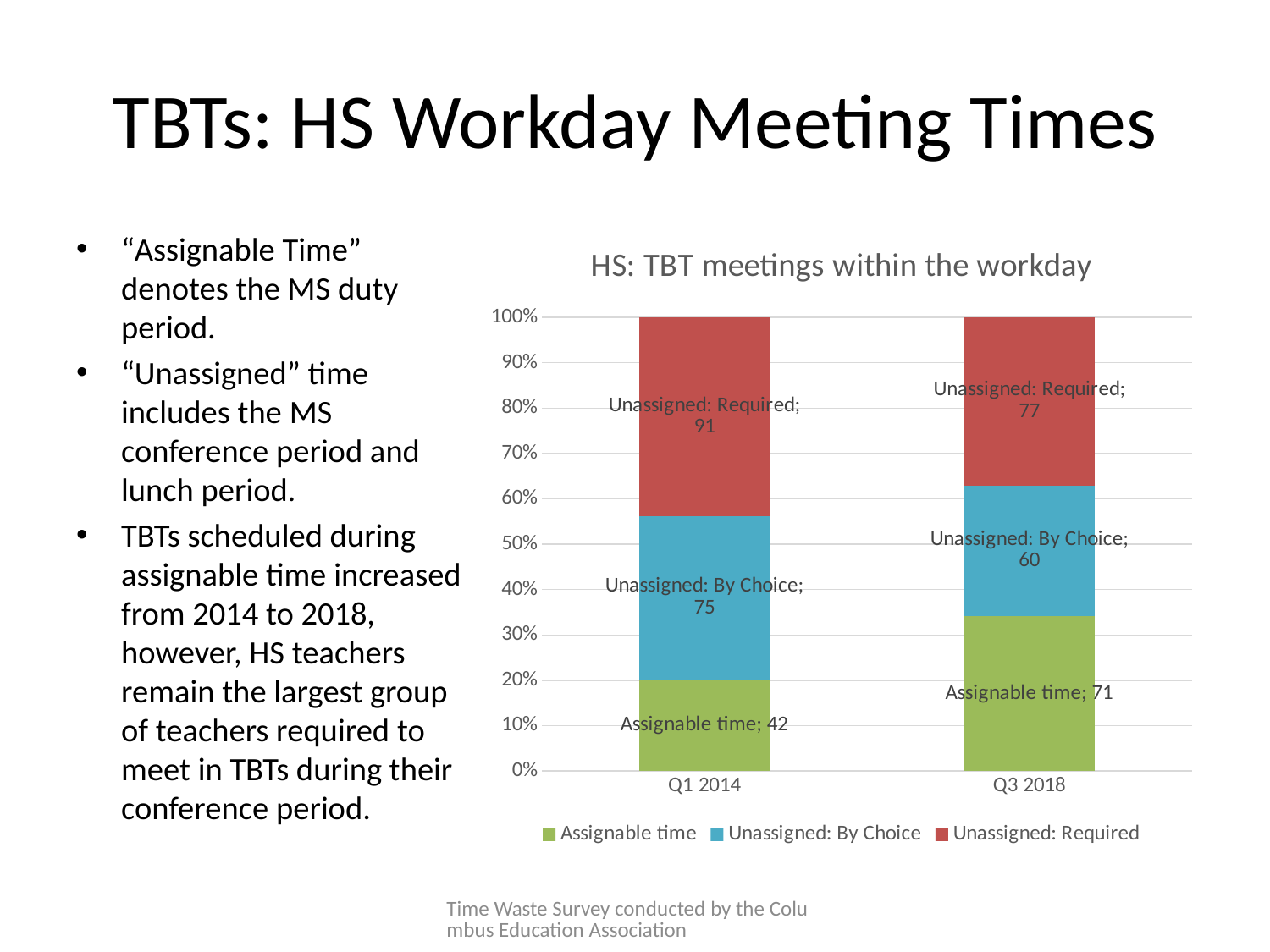
What is the value for Assignable time in Q3 2018? 71 How many categories are shown on the x axis? 2 Which series has the lowest value in Q3 2018? Unassigned: By Choice What is the value for Unassigned: By Choice in Q1 2014? 75 What type of chart is shown on the slide? Stacked bar chart Which series has the highest value in Q1 2014? Unassigned: Required What is the value for Unassigned: Required in Q3 2018? 77 What is the total of the three values in the Q1 2014 bar? 208 Which is larger, Unassigned: Required in Q1 2014 or Unassigned: Required in Q3 2018? Q1 2014 How many series does the legend list? 3 What is the difference between the Assignable time values for Q3 2018 and Q1 2014? 29 What is the value for Assignable time in Q1 2014? 42